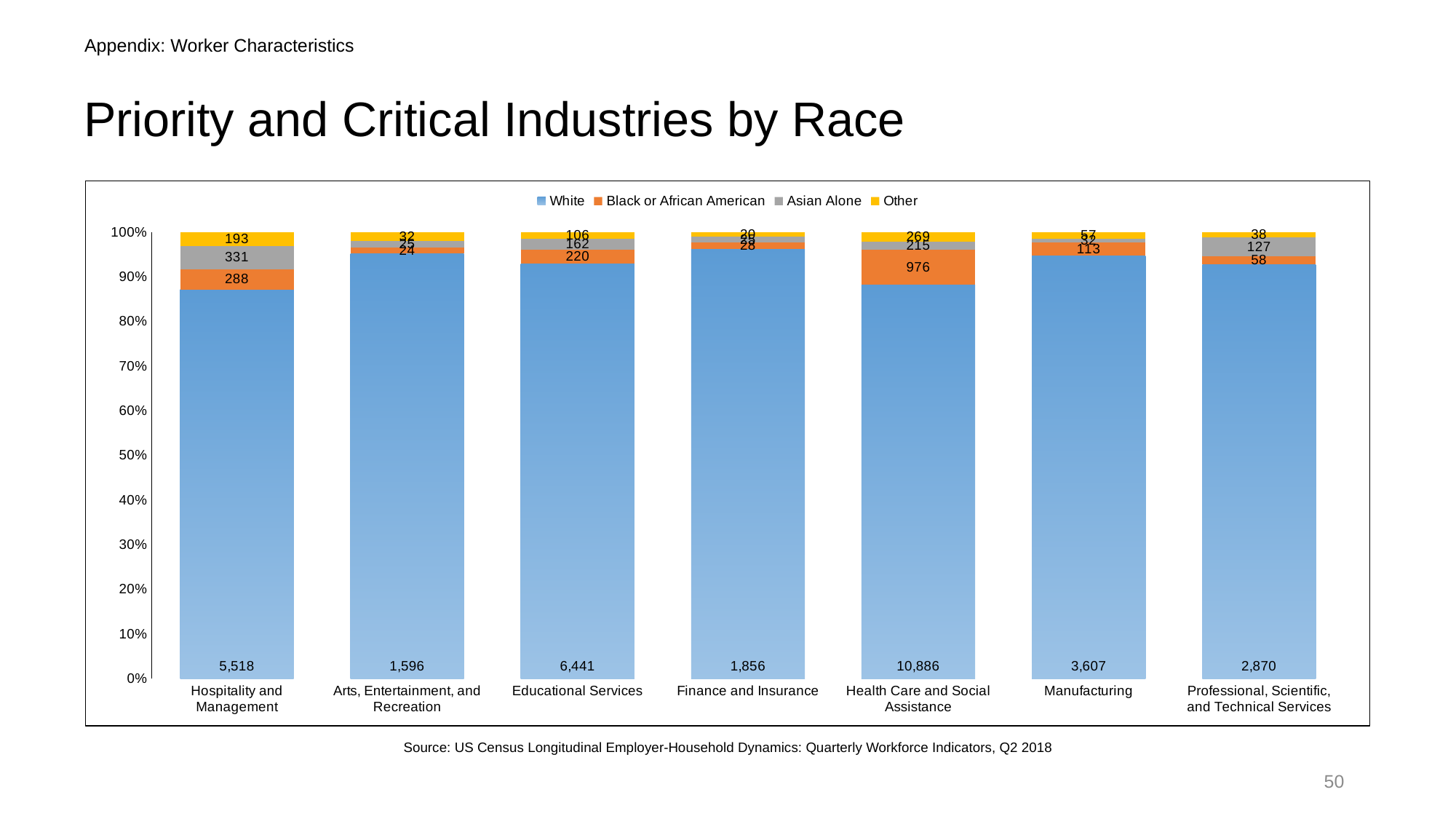
Which industry has the lowest White value? Arts, Entertainment, and Recreation What is the difference between the White values for Educational Services and Manufacturing? 2,834 How many series does the legend list? 4 What is the White value for Health Care and Social Assistance? 10,886 What is the Other value for Professional, Scientific, and Technical Services? 38 What kind of chart is shown on the slide? Stacked bar chart What is the Asian Alone value for Educational Services? 162 How many industries are shown on the x axis? 7 Which is larger, the Black or African American value for Health Care and Social Assistance or for Educational Services? Health Care and Social Assistance Which industry has the highest White value? Health Care and Social Assistance What is the Black or African American value for Hospitality and Management? 288 Is the White share of the Hospitality and Management bar greater or less than 90%? less